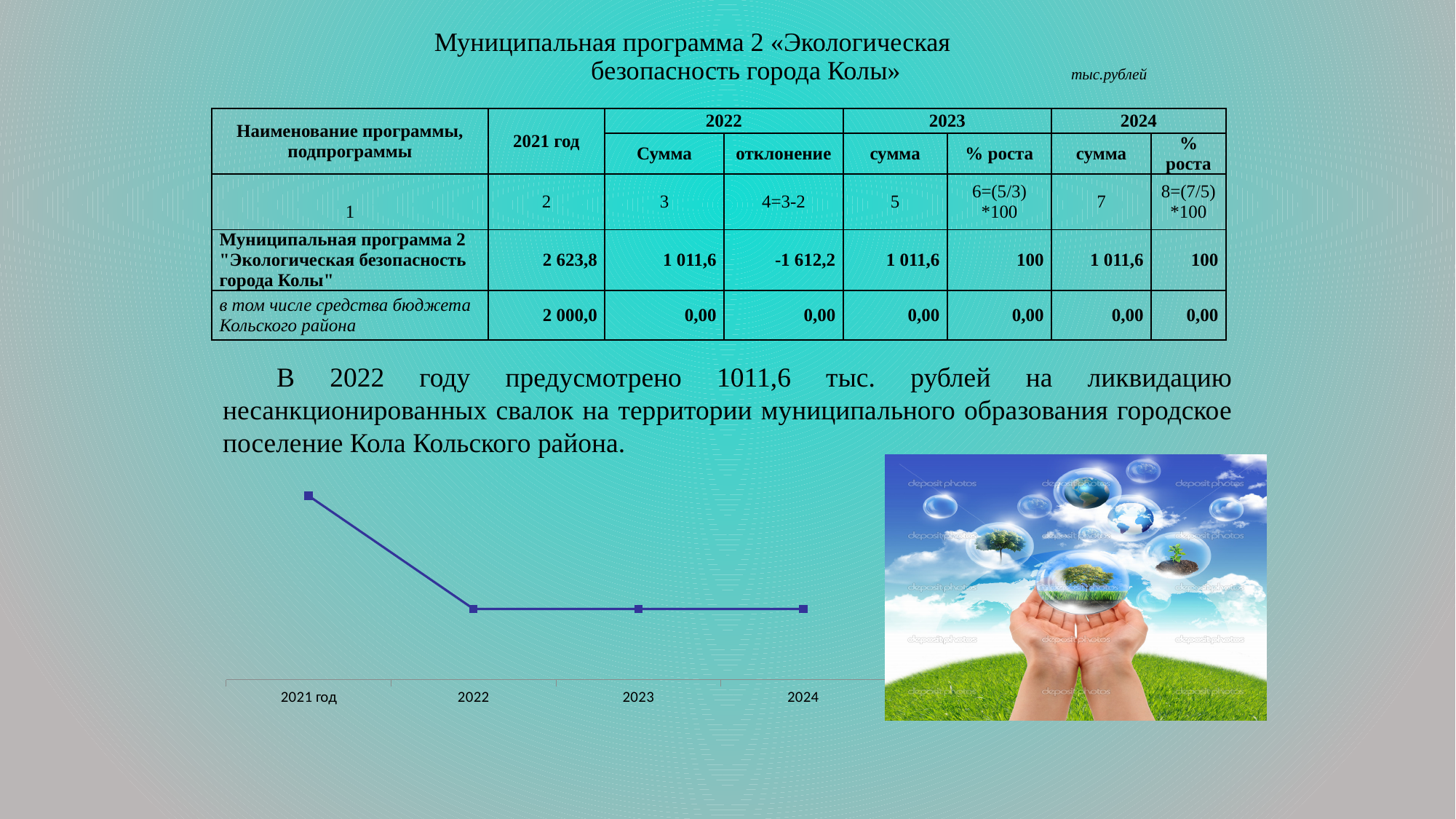
What is the first category label on the x axis of the line chart? 2021 год What kind of chart is shown at the bottom left of the slide? line chart Does the line chart rise or fall from 2021 год to 2022? fall What is the last category label on the x axis of the line chart? 2024 Which category has the highest value on the line chart? 2021 год What are the category labels along the x axis of the line chart? 2021 год, 2022, 2023, 2024 Which is larger on the line chart, the value for 2021 год or the value for 2023? 2021 год How many lines are plotted on the line chart? 1 How many data points are plotted on the line chart? 4 How does the line behave from 2022 to 2024 on the line chart? stays flat